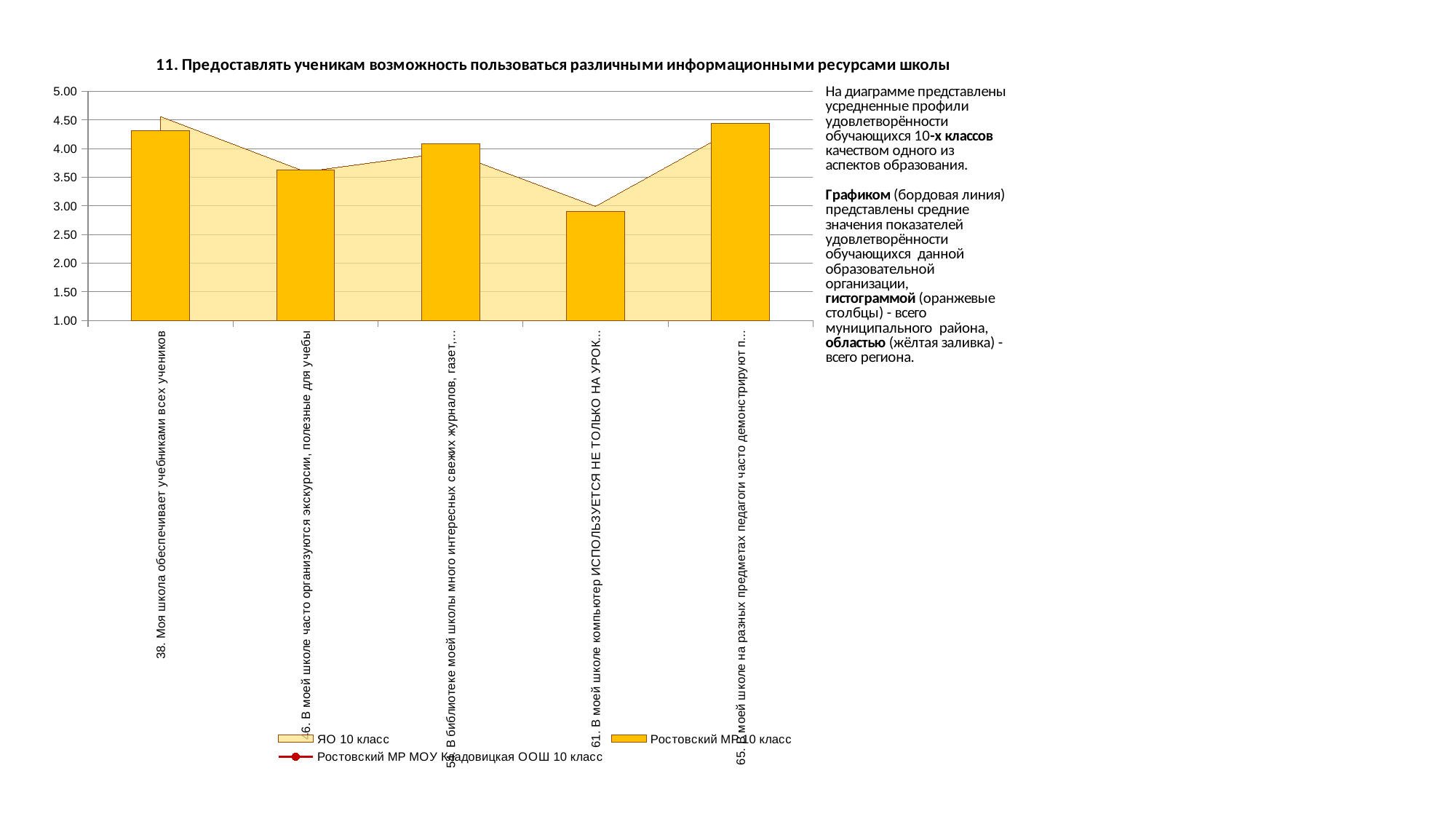
Is the bar value for statement 65 (В моей школе на разных предметах педагоги часто демонстрируют...) greater or less than 4.00? greater What is the title of the chart? 11. Предоставлять ученикам возможность пользоваться различными информационными ресурсами школы How many series does the chart's legend list? 3 Is the bar value for statement 38 (Моя школа обеспечивает учебниками всех учеников) greater or less than 4.00? greater Which series is shown as orange bars according to the legend? Ростовский МР 10 класс Which statement has the lowest bar for Ростовский МР 10 класс? 61. В моей школе компьютер ИСПОЛЬЗУЕТСЯ НЕ ТОЛЬКО НА УРОК... Which is larger: the Ростовский МР 10 класс bar for statement 38 or the bar for statement 61? Statement 38 Is the bar value for the statement about excursions (В моей школе часто организуются экскурсии, полезные для учебы) greater or less than 4.00? less For statement 38, which is higher: the ЯО 10 класс area value or the Ростовский МР 10 класс bar? The ЯО 10 класс area value What kind of chart is shown on the slide? A combination chart with bars, an area and a line How many categories (statements) are shown on the x axis of the chart? 5